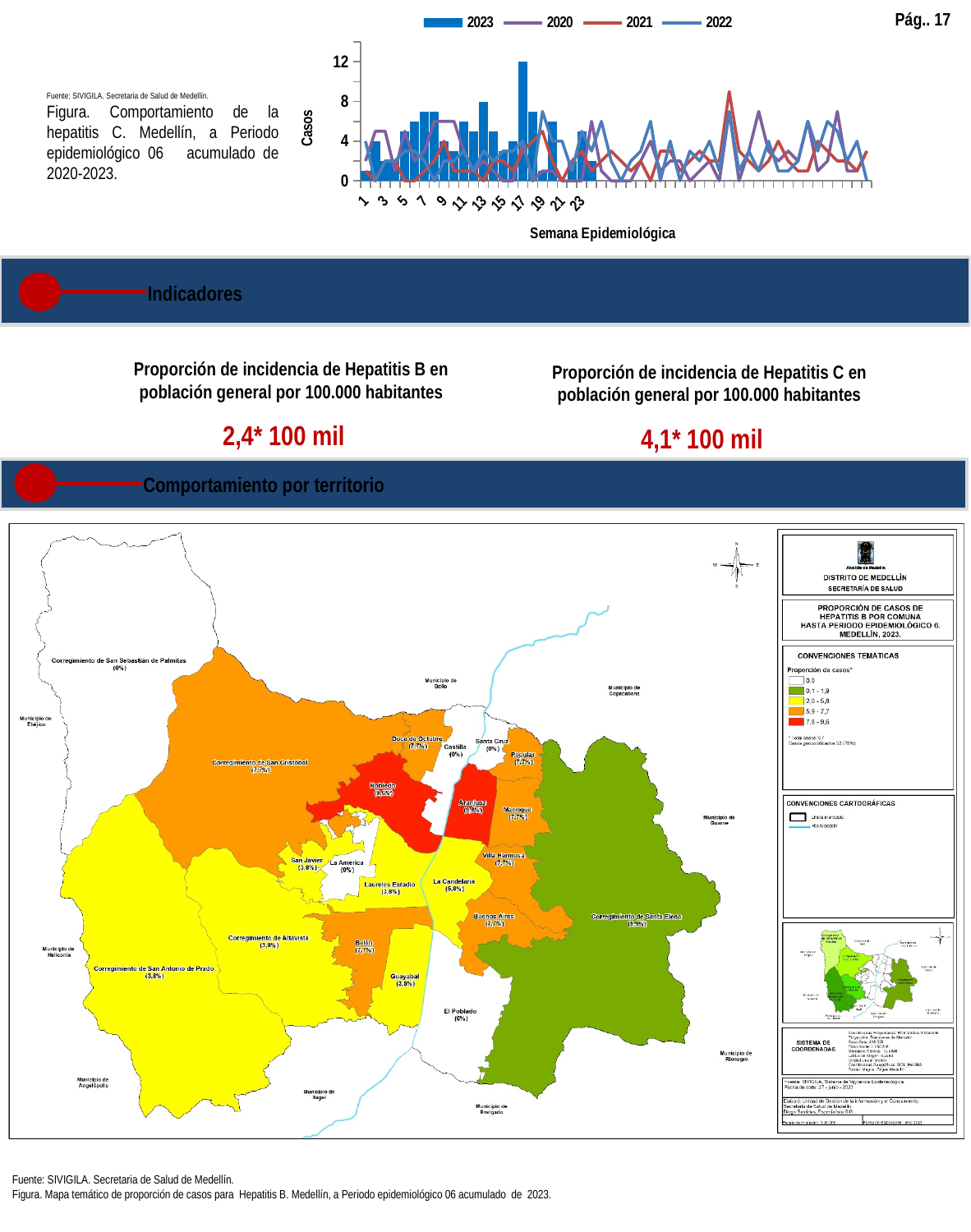
In the top chart, is the 2023 value at week 17 greater or less than 8? greater In the top chart, at which epidemiological week does the 2023 series reach its highest value? 17 In the top chart, is the 2023 value at week 7 greater or less than 4? greater Which series in the top chart is drawn as bars? 2023 What kind of chart is shown at the top of the slide? A combined bar and line chart In the top chart, is the 2023 value at week 1 greater or less than 4? less In the top chart, which is larger for 2023: the value at week 17 or the value at week 13? Week 17 How many series does the legend of the top chart list? 4 What is the label of the vertical axis of the top chart? Casos What is the highest tick value shown on the vertical axis of the top chart? 12